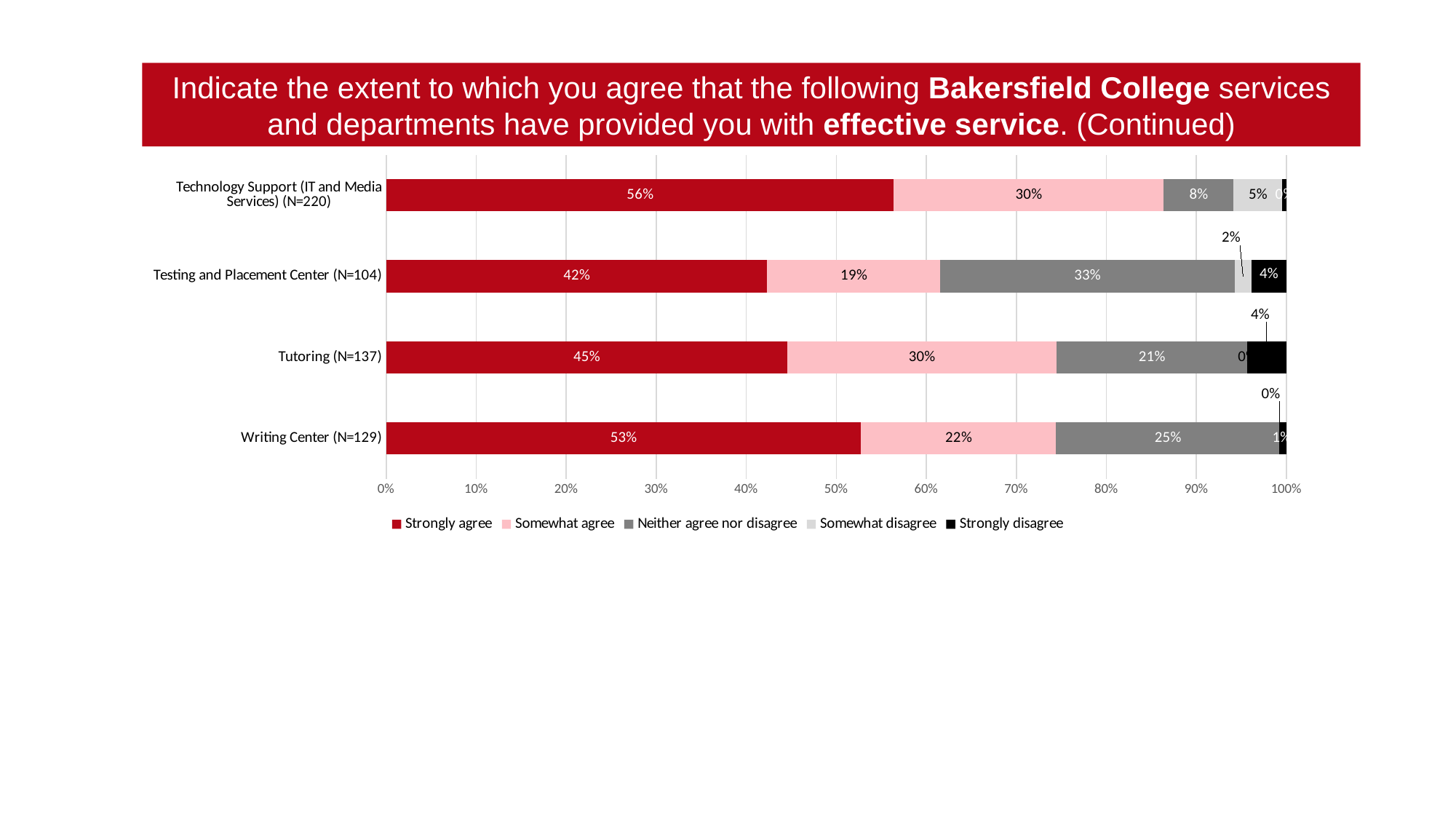
Which legend entry is shown in black? Strongly disagree Which service has the lowest Strongly agree percentage? Testing and Placement Center (N=104) What percentage of respondents strongly agree that Technology Support (IT and Media Services) provided effective service? 56% Which has a larger Neither agree nor disagree value, Tutoring or Writing Center? Writing Center Which service has the highest Strongly agree percentage? Technology Support (IT and Media Services) (N=220) What is the Somewhat agree value for Writing Center (N=129)? 22% How many response categories does the legend list? 5 What is the Strongly disagree value for Tutoring (N=137)? 4% What is the difference between the Strongly agree values for Writing Center and Tutoring? 8% What is the Neither agree nor disagree value for Testing and Placement Center (N=104)? 33% What type of chart is shown on the slide? Stacked bar chart How many services are shown in the chart? 4